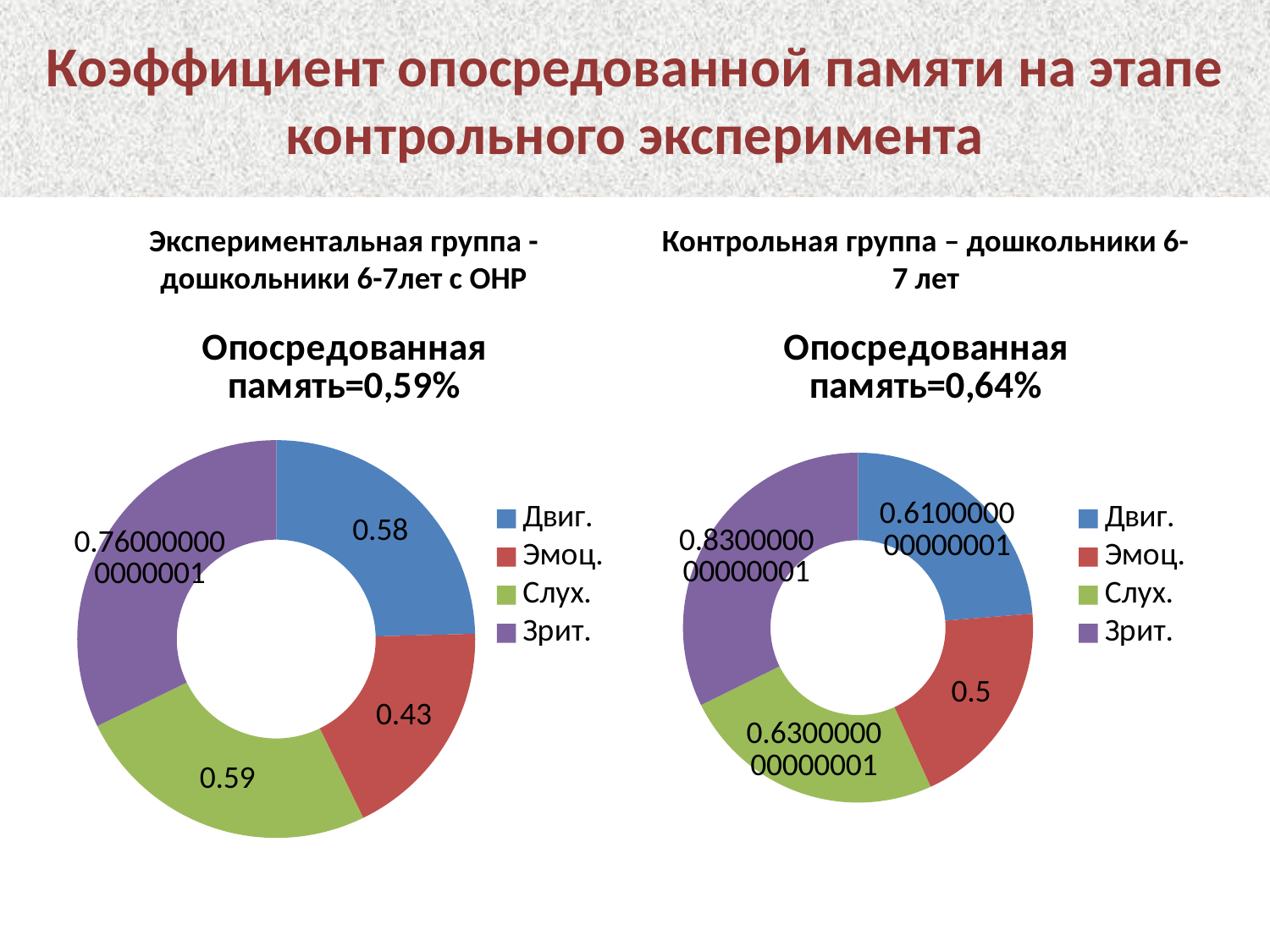
In the left chart (Экспериментальная группа), what is the difference between the values for Слух. and Эмоц.? 0.16 How many categories does the legend of the left chart (Экспериментальная группа) list? 4 In the right chart (Контрольная группа), which category has the largest value? Зрит. In the right chart (Контрольная группа), what is the value for Эмоц.? 0.5 In the left chart (Экспериментальная группа), which category has the largest value? Зрит. In the left chart (Экспериментальная группа), which category has the smallest value? Эмоц. In the right chart (Контрольная группа), which is larger, the value for Зрит. or the value for Эмоц.? Зрит. What kind of chart is the right chart (Контрольная группа)? Doughnut (pie) chart In the left chart (Экспериментальная группа), what is the value for Эмоц.? 0.43 In the left chart (Экспериментальная группа), what is the value for Слух.? 0.59 In the right chart (Контрольная группа), which category has the smallest value? Эмоц. In the left chart (Экспериментальная группа), what is the value for Двиг.? 0.58